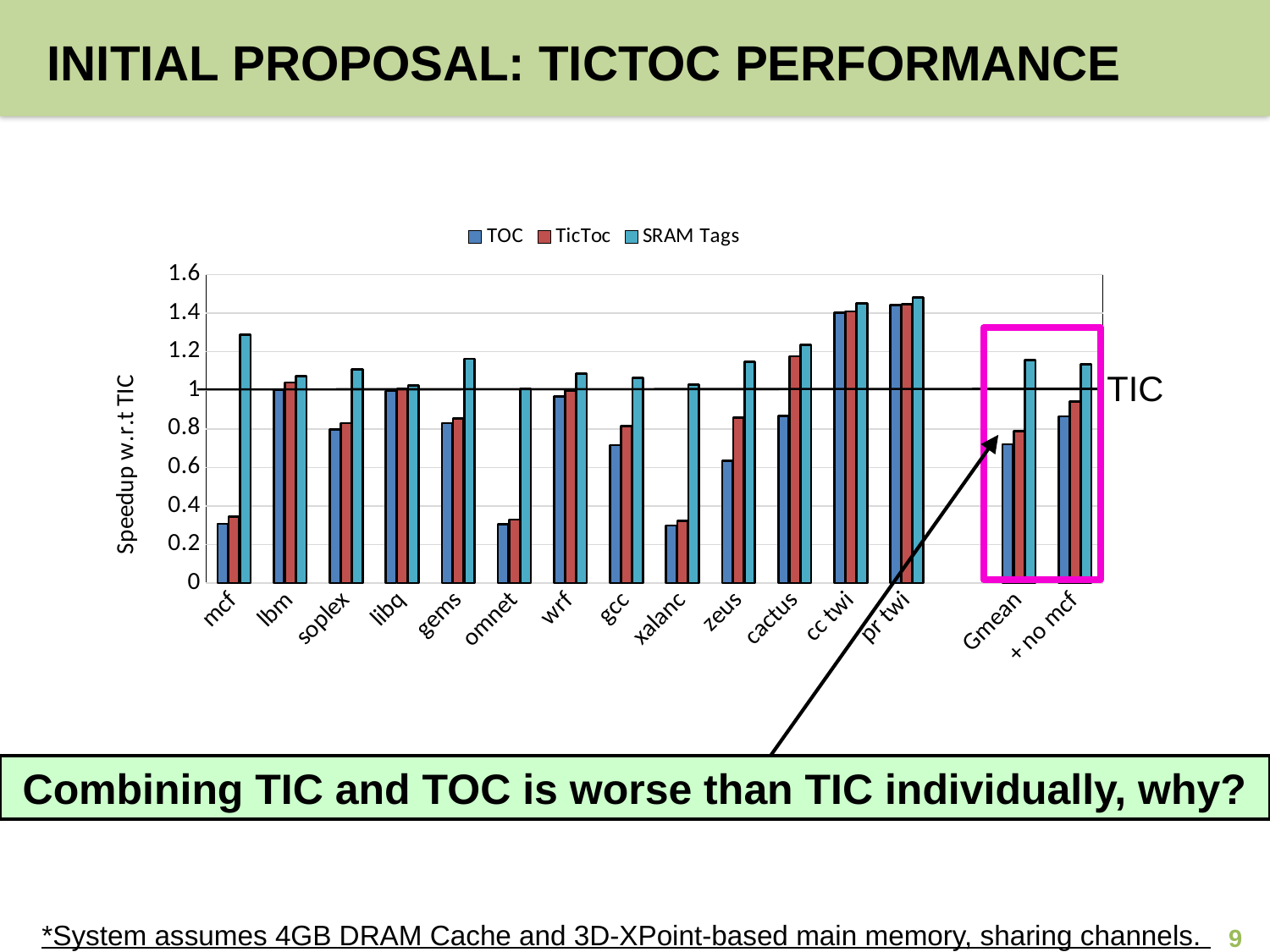
How many series does the legend list? 3 Is the TOC value for mcf greater or less than 0.4? less For mcf, which is larger: the SRAM Tags value or the TOC value? SRAM Tags What is the label on the y axis? Speedup w.r.t TIC Is the TOC value for Gmean greater or less than 0.8? less What kind of chart is shown on the slide? bar chart How many categories are shown along the x axis? 15 Is the SRAM Tags value for pr twi greater or less than 1.4? greater Which is larger: the TOC value for gcc or the TOC value for zeus? gcc What are the three series named in the legend? TOC, TicToc, SRAM Tags